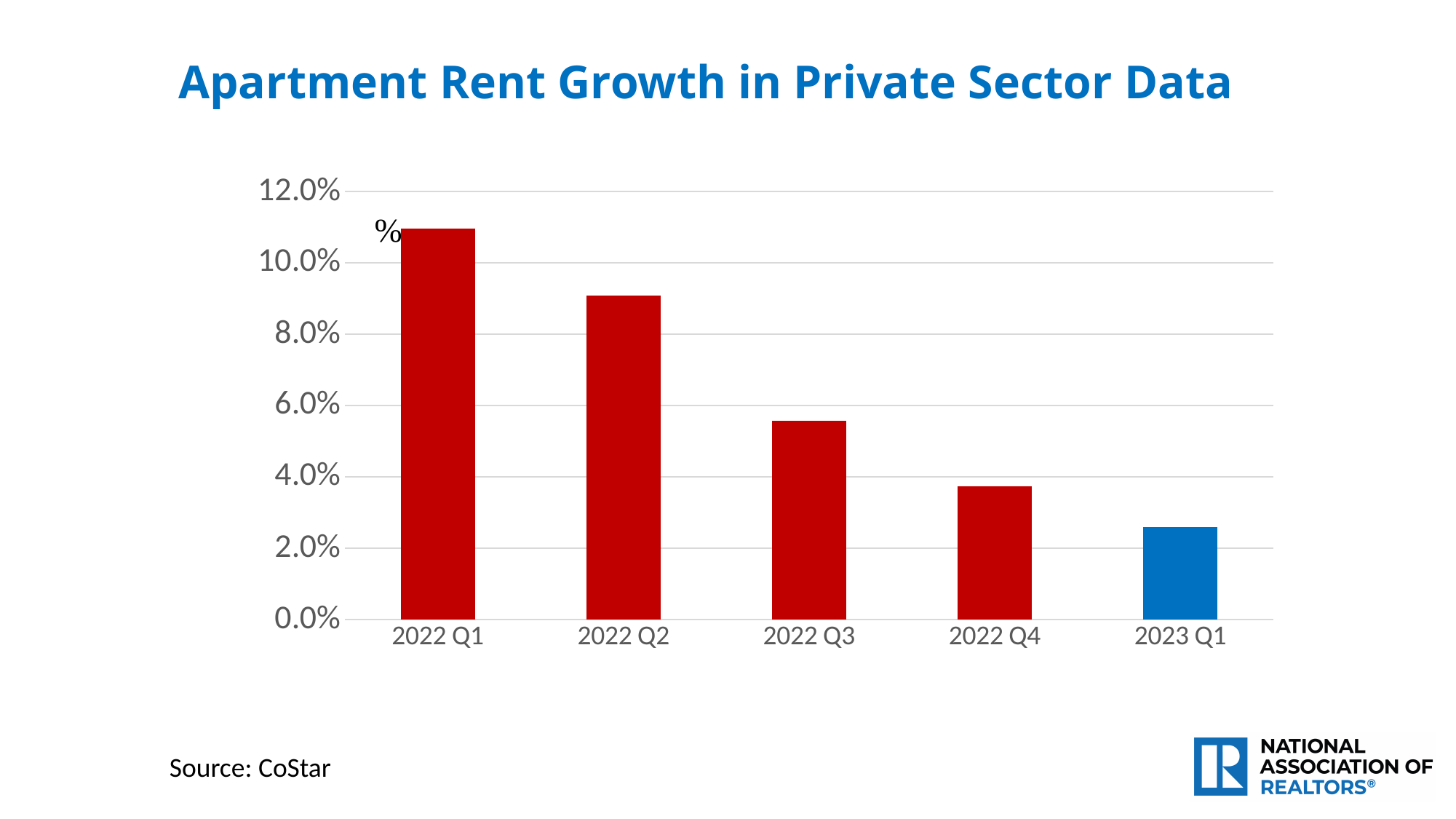
What is the title of the chart? Apartment Rent Growth in Private Sector Data Which is larger, the value for 2022 Q2 or the value for 2022 Q3? 2022 Q2 Is the value for 2022 Q3 greater or less than 6.0%? less Which quarter has the lowest apartment rent growth? 2023 Q1 Is the value for 2022 Q2 greater or less than 8.0%? greater Is the value for 2022 Q4 greater or less than 4.0%? less How many quarters are plotted on the chart? 5 Do the values rise or fall from 2022 Q1 to 2023 Q1? fall Which quarter has the highest apartment rent growth? 2022 Q1 What kind of chart is shown on the slide? bar chart